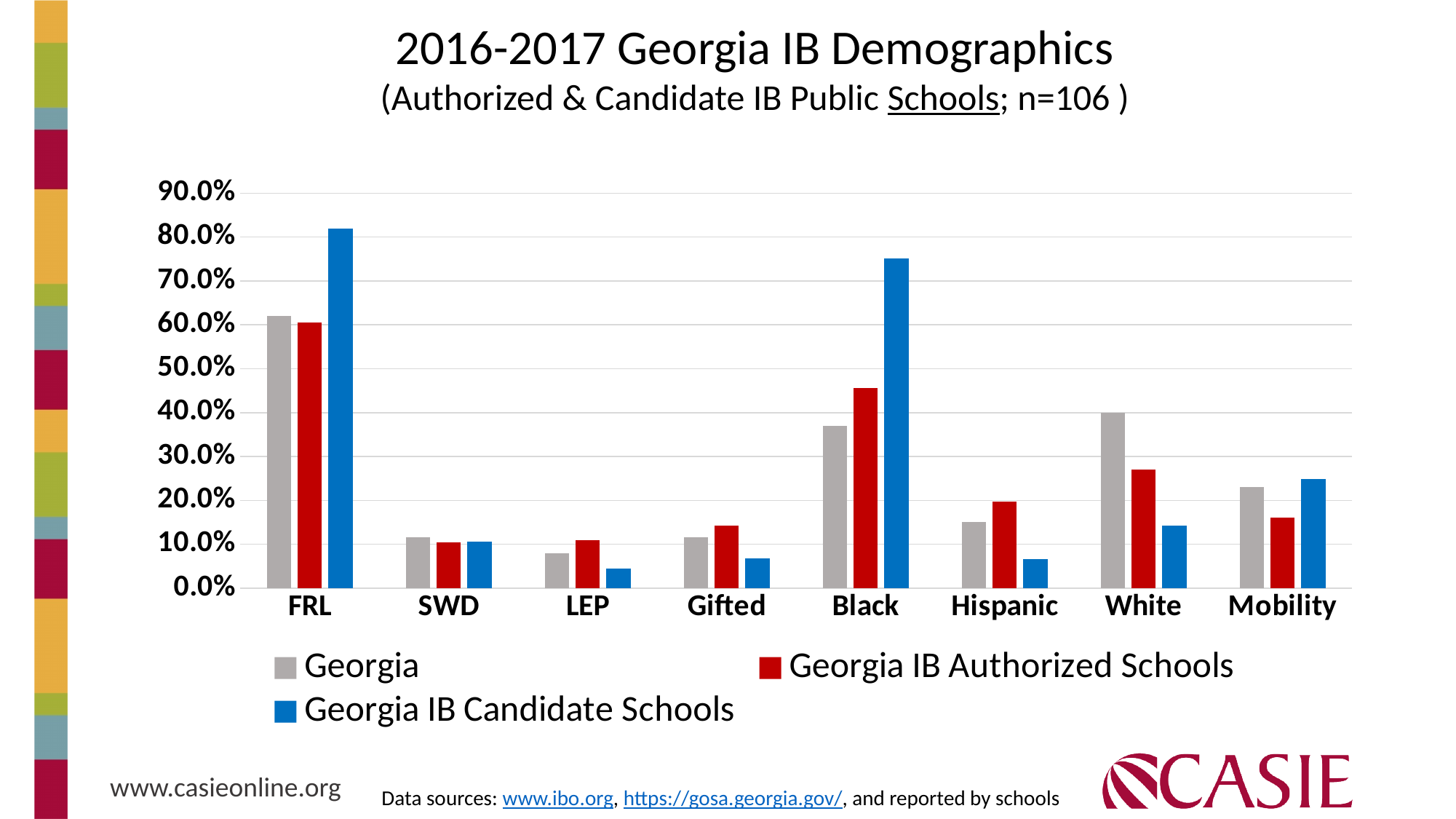
How many categories are shown along the x axis of the chart? 8 Is the value for Georgia IB Candidate Schools in the FRL category greater or less than 70.0%? greater How many series does the chart's legend list? 3 In the Black category, which is larger: the value for Georgia IB Authorized Schools or the value for Georgia IB Candidate Schools? Georgia IB Candidate Schools Which category has the lowest value for Georgia IB Candidate Schools? LEP Is the value for Georgia in the White category greater or less than 30.0%? greater Is the value for Georgia IB Candidate Schools in the Hispanic category greater or less than 10.0%? less What colour represents Georgia IB Authorized Schools in the chart? Red Which category has the highest value for Georgia IB Candidate Schools? FRL In the White category, which is larger: the value for Georgia or the value for Georgia IB Candidate Schools? Georgia What kind of chart is shown on the slide? Bar chart